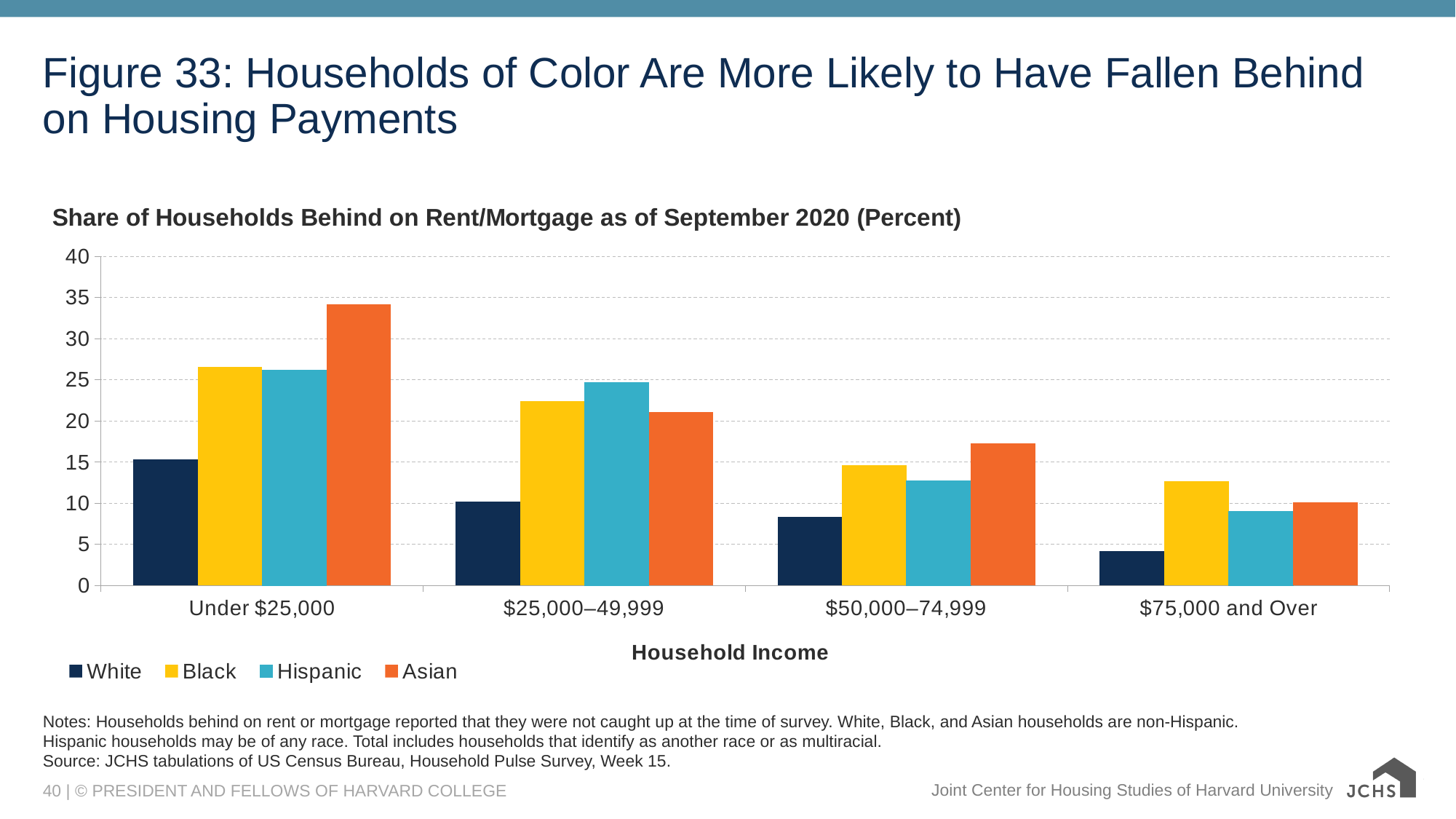
What kind of chart is shown on the slide? Bar chart Is the value for Black households in the $75,000 and Over group greater or less than 10? greater In the Under $25,000 income group, which series has the highest share of households behind on rent/mortgage? Asian In the $75,000 and Over income group, which series has the lowest share? White Is the value for White households in the $25,000–49,999 group greater or less than 15? less How many household income categories are shown on the x axis? 4 Is the value for Asian households in the Under $25,000 group greater or less than 30? greater What is the title of the x axis? Household Income Do the values for White households rise or fall as household income increases along the x axis? Fall How many series does the legend list? 4 In the $25,000–49,999 group, which series has the highest share? Hispanic In the $50,000–74,999 group, which is larger: the Asian value or the Hispanic value? Asian